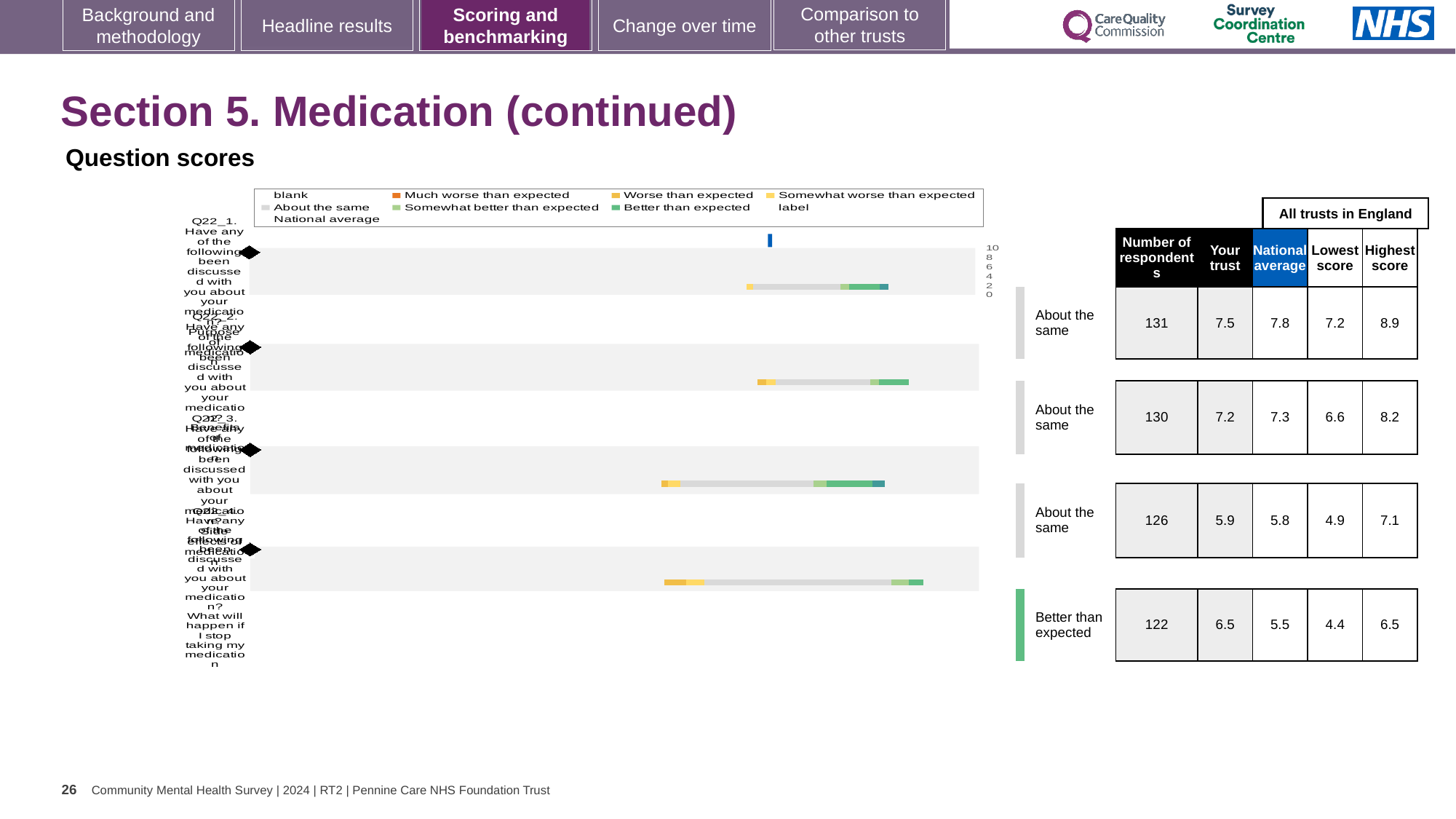
How many rows are rated 'About the same'? 3 In the table beside the chart, what is the 'Your trust' score for the first row (Q22_1)? 7.5 Which row in the table has the highest 'Your trust' score? the first row (Q22_1), 7.5 For the fourth row (Q22_4), what is the difference between the 'Your trust' score (6.5) and the 'National average' (5.5)? 1.0 Which row is rated 'Better than expected'? the fourth row (Q22_4) How many question rows (bars) are plotted in the chart? 4 In the table beside the chart, how many respondents are listed for the fourth row (Q22_4)? 122 How many entries does the chart legend list? 9 For the fourth row (Q22_4), which is larger: the 'Your trust' score or the 'National average'? Your trust What is the highest value shown on the chart's axis? 10 What kind of chart is shown on the slide? bar chart What is the heading above the chart? Question scores